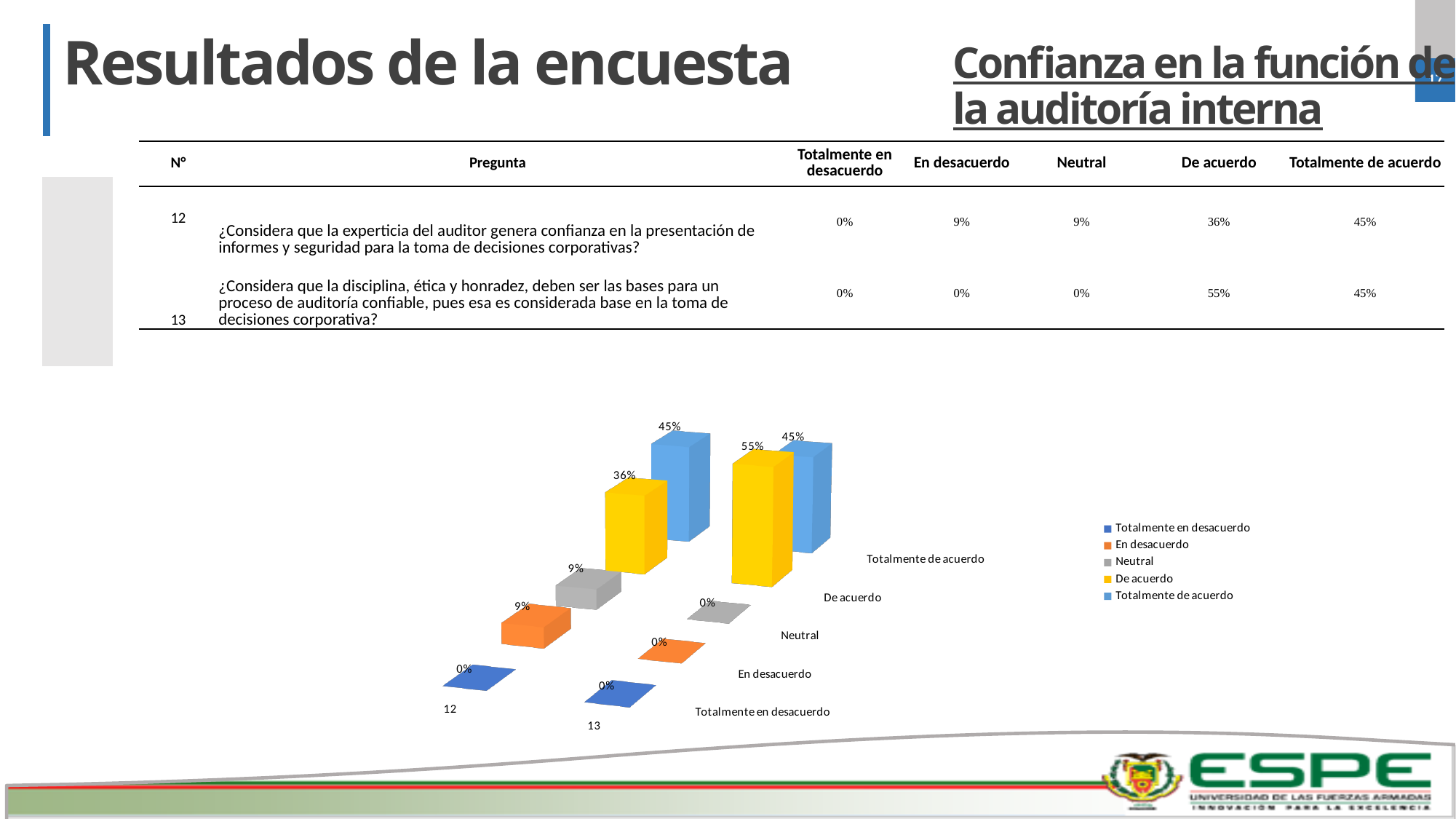
How many series does the legend list? 5 What is the value for "En desacuerdo" for question 12? 9% What is the value for "De acuerdo" for question 13? 55% Which is larger for question 12: "De acuerdo" or "Totalmente de acuerdo"? Totalmente de acuerdo What kind of chart is shown on the slide? Bar chart What is the difference between the "De acuerdo" values for question 13 and question 12? 19% What is the value for "Totalmente de acuerdo" for question 12? 45% Which series has the highest value for question 12? Totalmente de acuerdo What is the value for "Neutral" for question 13? 0% How many question categories are plotted on the chart? 2 What is the value for "De acuerdo" for question 12? 36% Which series has the highest value for question 13? De acuerdo